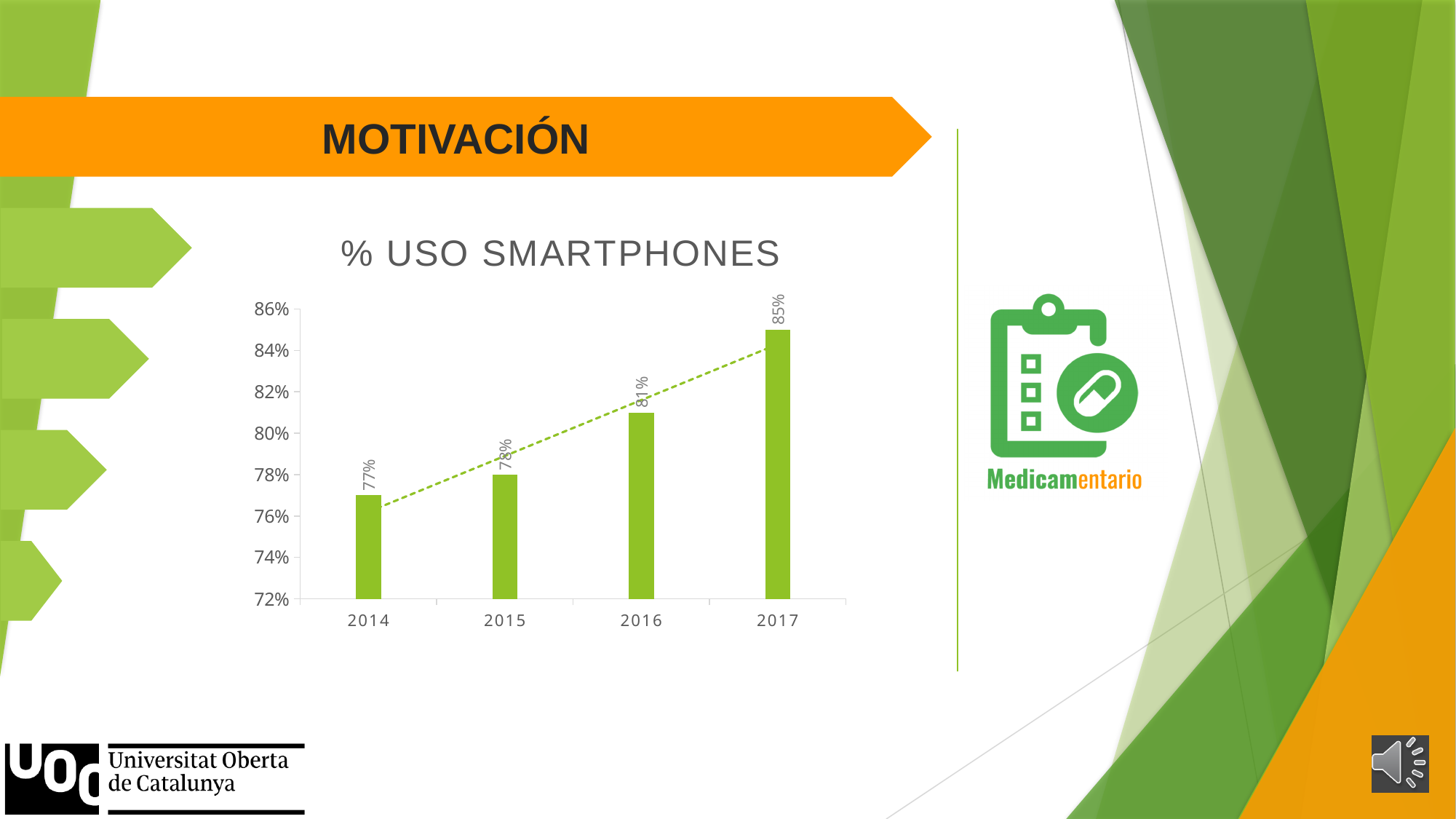
What is the value for 2017? 85% Do the values rise or fall from 2014 to 2017? rise What is the value for 2014? 77% What kind of chart is shown? bar chart How many years are shown on the x axis? 4 Which year has the highest value? 2017 What is the difference between the values for 2017 and 2014? 8% What is the value for 2016? 81% What is the value for 2015? 78% Which year has the lowest value? 2014 Is the value for 2016 greater or less than 80%? greater Which is larger, the value for 2016 or the value for 2015? 2016